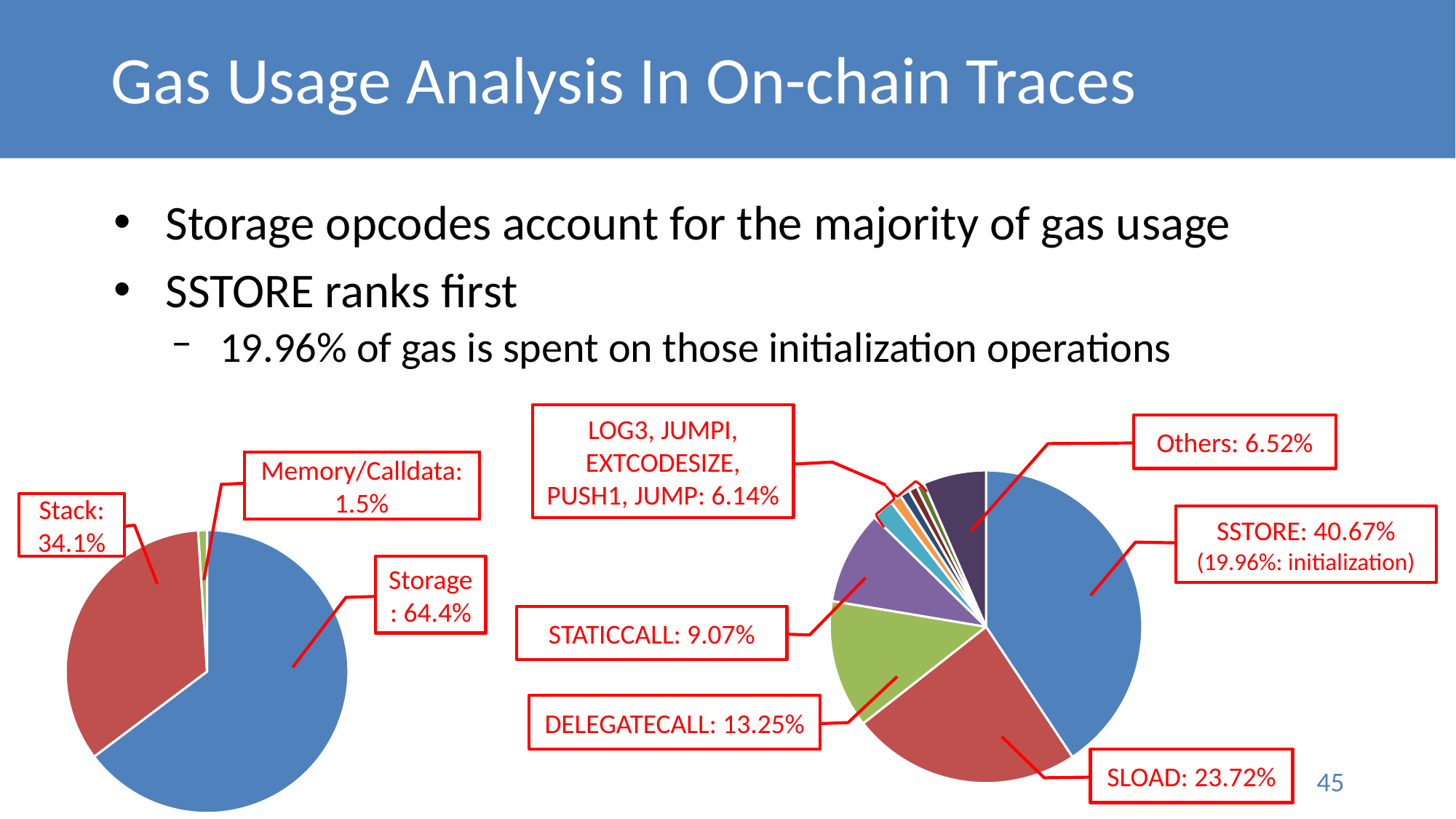
In the right pie chart, what is the value for SSTORE? 40.67% In the left pie chart, how many slices are there? 3 In the right pie chart, what is the value for DELEGATECALL? 13.25% In the left pie chart, what is the value for Stack? 34.1% In the right pie chart, which labelled opcode has the largest share? SSTORE In the right pie chart, what is the difference in percentage points between SSTORE and SLOAD? 16.95 In the left pie chart, what share of gas usage is attributed to Storage? 64.4% In the left pie chart, what is the value for Memory/Calldata? 1.5% In the left pie chart, which category has the smallest share? Memory/Calldata In the right pie chart, which is larger, STATICCALL or SLOAD? SLOAD In the left pie chart, what is the difference in percentage points between Storage and Stack? 30.3 What type of chart is shown on the right of the slide? Pie chart